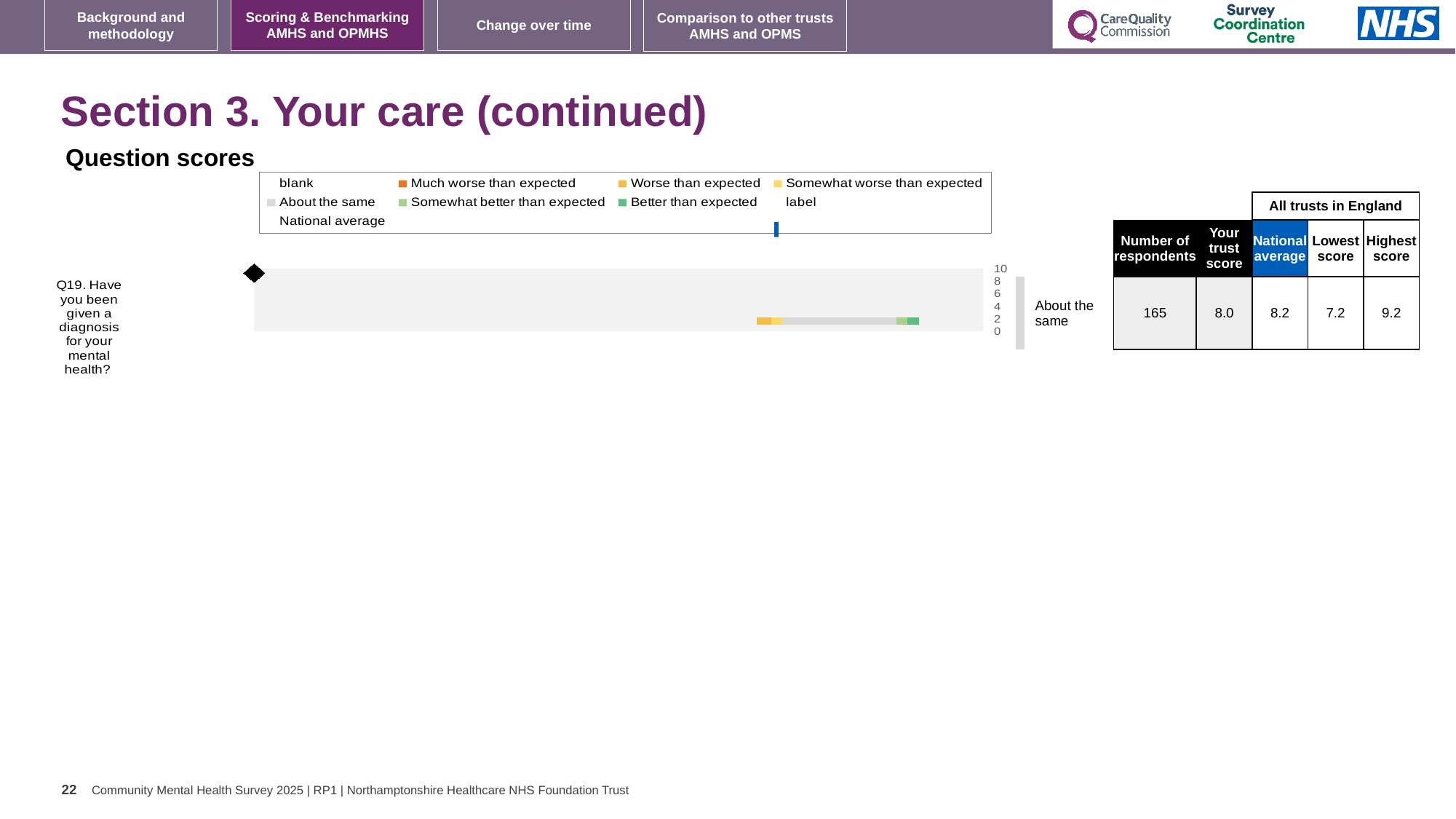
What is the difference between the highest and lowest trust scores for Q19? 2.0 What is the highest score among all trusts in England for Q19? 9.2 What is the national average score for Q19 shown in the table beside the chart? 8.2 How many survey questions are plotted in the chart on this slide? 1 What is the heading above the chart on this slide? Question scores What kind of chart is used to show the Q19 score? Bar chart How many respondents answered Q19 according to the table beside the chart? 165 Which is larger for Q19: the trust's score or the national average? National average What is the difference between the national average and the trust's score for Q19? 0.2 What is the trust's score for Q19 (Have you been given a diagnosis for your mental health?) shown in the table beside the chart? 8.0 How is the trust's Q19 score categorised relative to other trusts, according to the label next to the chart? About the same What is the lowest score among all trusts in England for Q19? 7.2